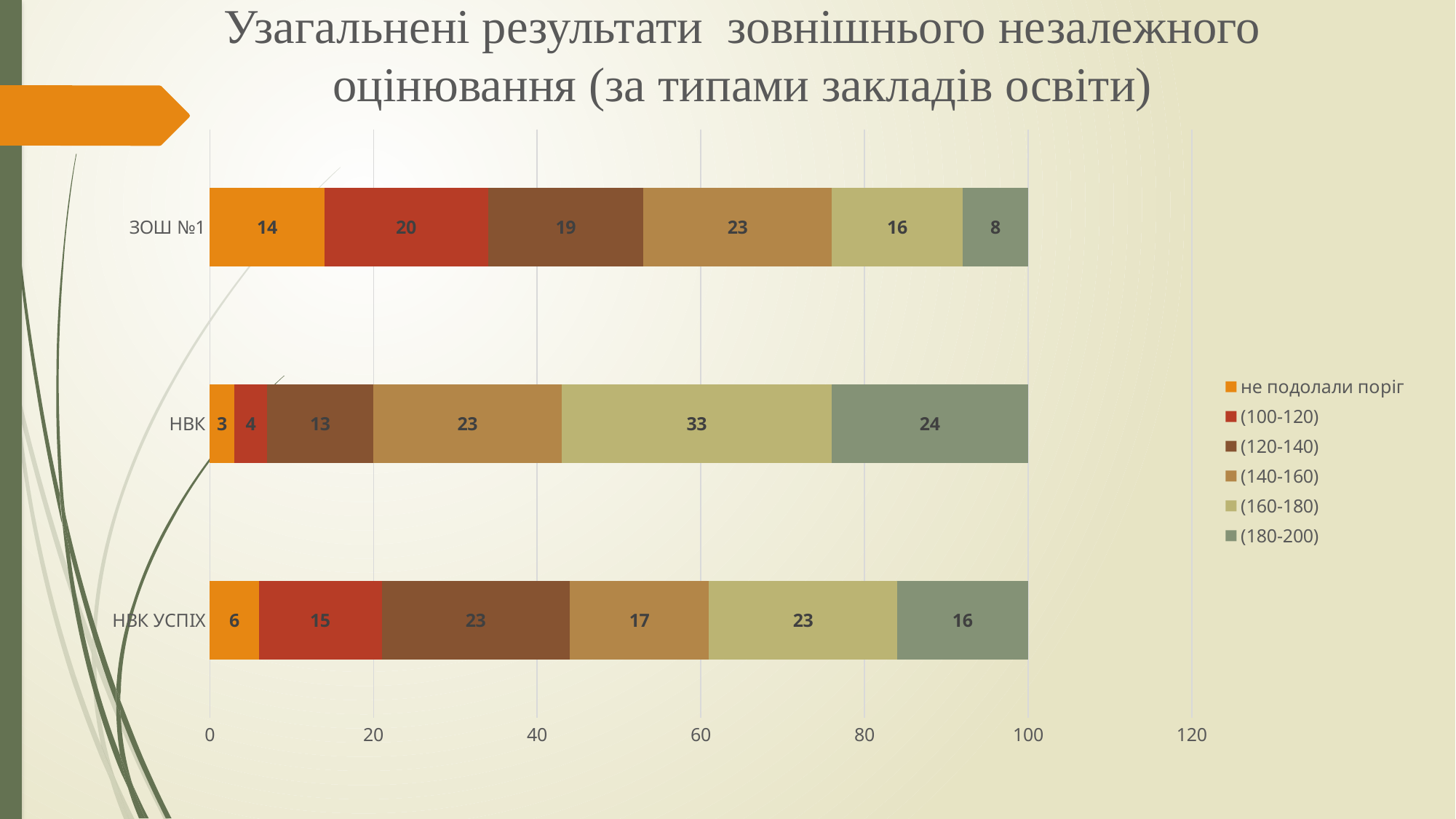
What is the value of the (120-140) series for НВК УСПІХ? 23 What is the difference between the (100-120) values for ЗОШ №1 and НВК? 16 What is the value of the (160-180) series for НВК? 33 What is the total of the stacked bar for НВК УСПІХ? 100 What type of chart is shown on the slide? stacked bar chart What is the value of the 'не подолали поріг' series for ЗОШ №1? 14 Which is larger: the (140-160) value for ЗОШ №1 or for НВК УСПІХ? ЗОШ №1 Which category has the highest value in the (180-200) series? НВК What is the title of the chart on the slide? Узагальнені результати зовнішнього незалежного оцінювання (за типами закладів освіти) How many series does the legend list? 6 How many categories (institutions) are plotted on the chart? 3 Which category has the lowest value in the 'не подолали поріг' series? НВК